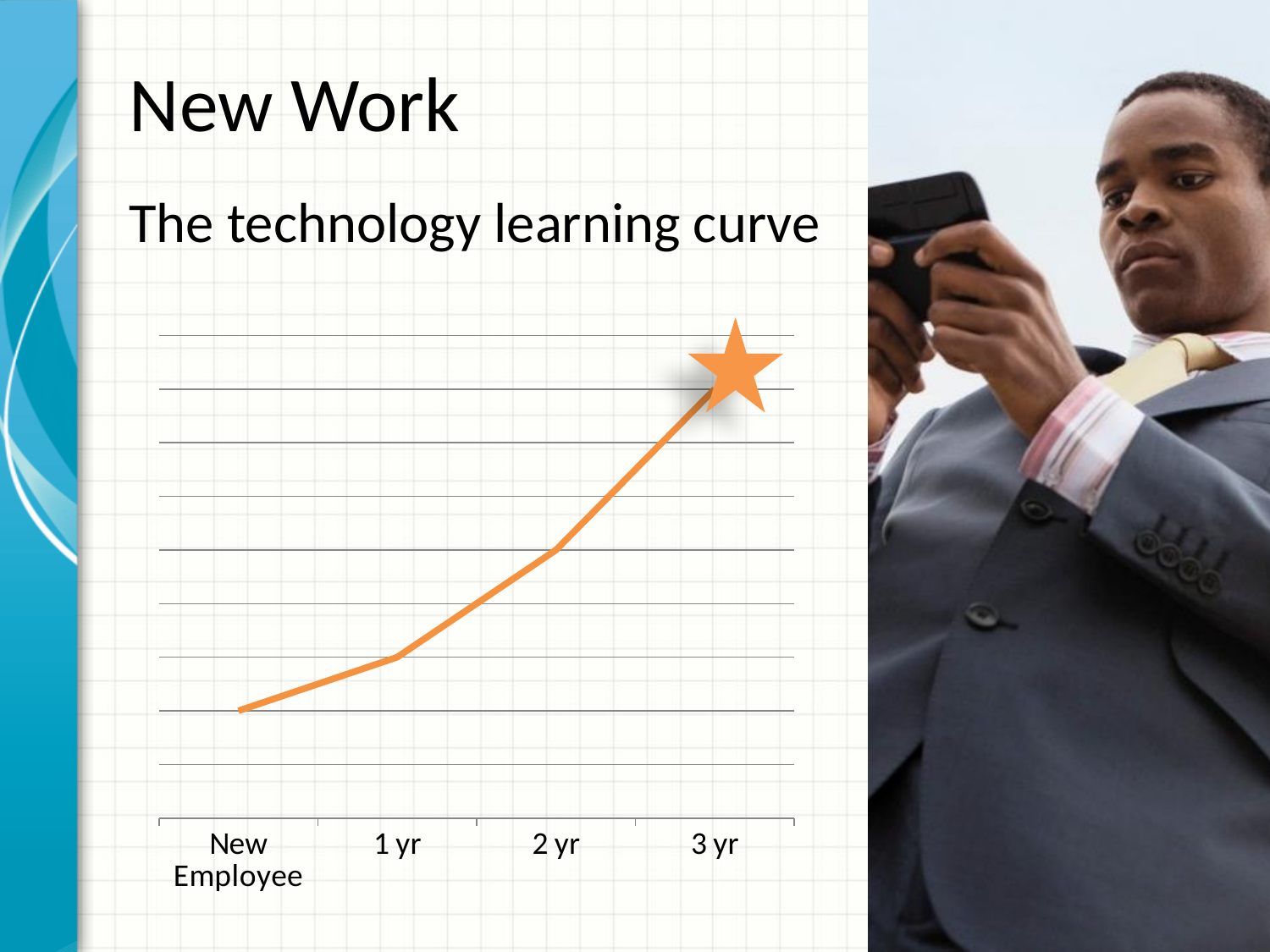
Which category has the highest value in the chart? 3 yr Do the values in the chart rise or fall from New Employee to 3 yr? rise What colour is the line in the chart? orange Which has the smaller value in the chart, 1 yr or 3 yr? 1 yr What is the first category on the x axis of the chart? New Employee Which category has the lowest value in the chart? New Employee Which has the larger value in the chart, New Employee or 3 yr? 3 yr Which has the larger value in the chart, 1 yr or 2 yr? 2 yr What kind of chart is shown on the slide? line chart How many categories are shown on the x axis of the chart? 4